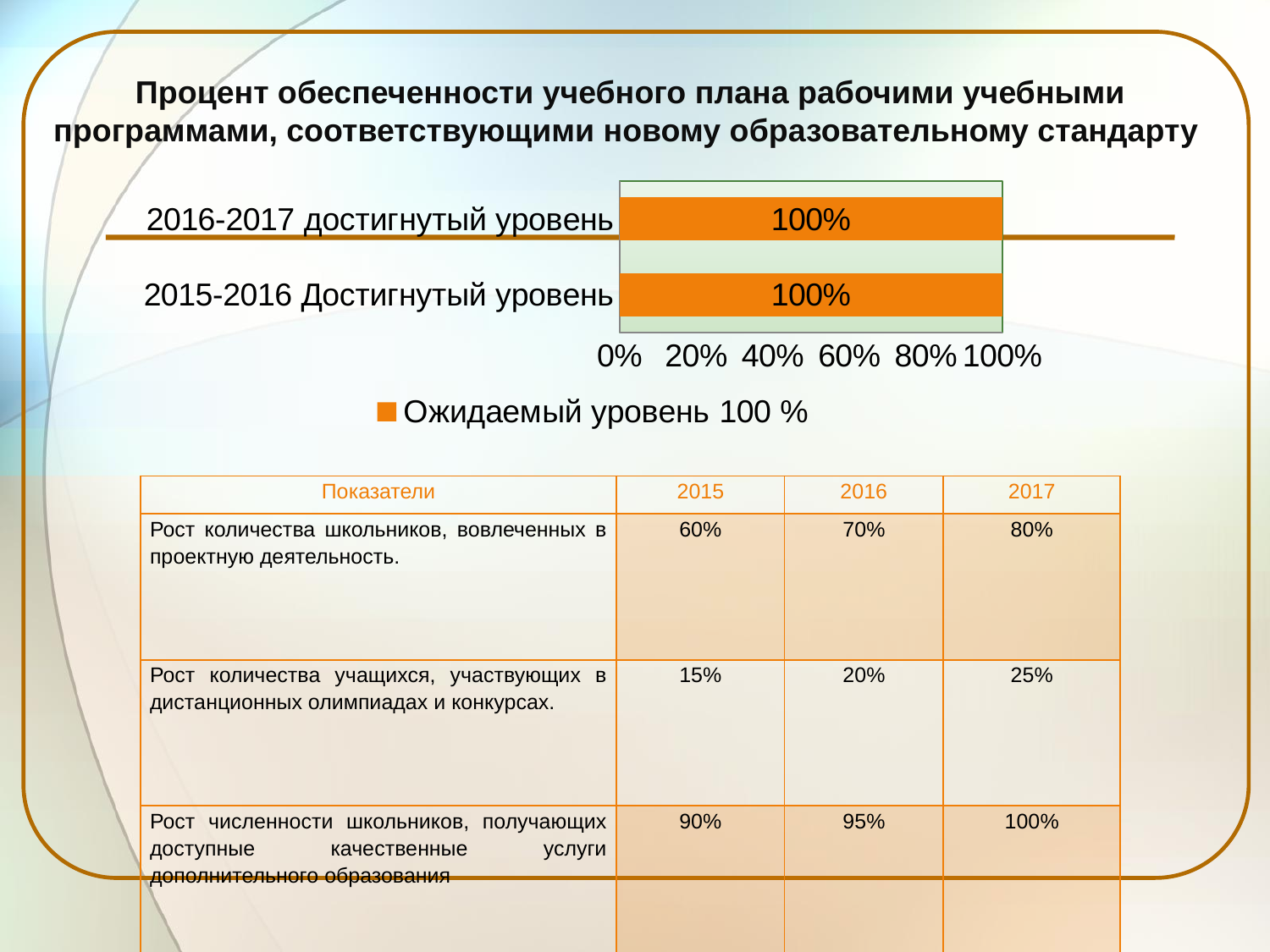
Is the value for "2016-2017 достигнутый уровень" greater or less than 60%? greater What is the legend entry of the series in the bar chart? Ожидаемый уровень 100 % How many series does the chart legend list? 1 What is the value for "2016-2017 достигнутый уровень"? 100% What is the difference between the values for "2016-2017 достигнутый уровень" and "2015-2016 Достигнутый уровень"? 0% How many categories are plotted in the bar chart? 2 Is the value for "2015-2016 Достигнутый уровень" greater or less than 80%? greater What kind of chart is shown on the slide? bar chart What is the value for "2015-2016 Достигнутый уровень"? 100% What is the highest value shown on the horizontal axis of the bar chart? 100%